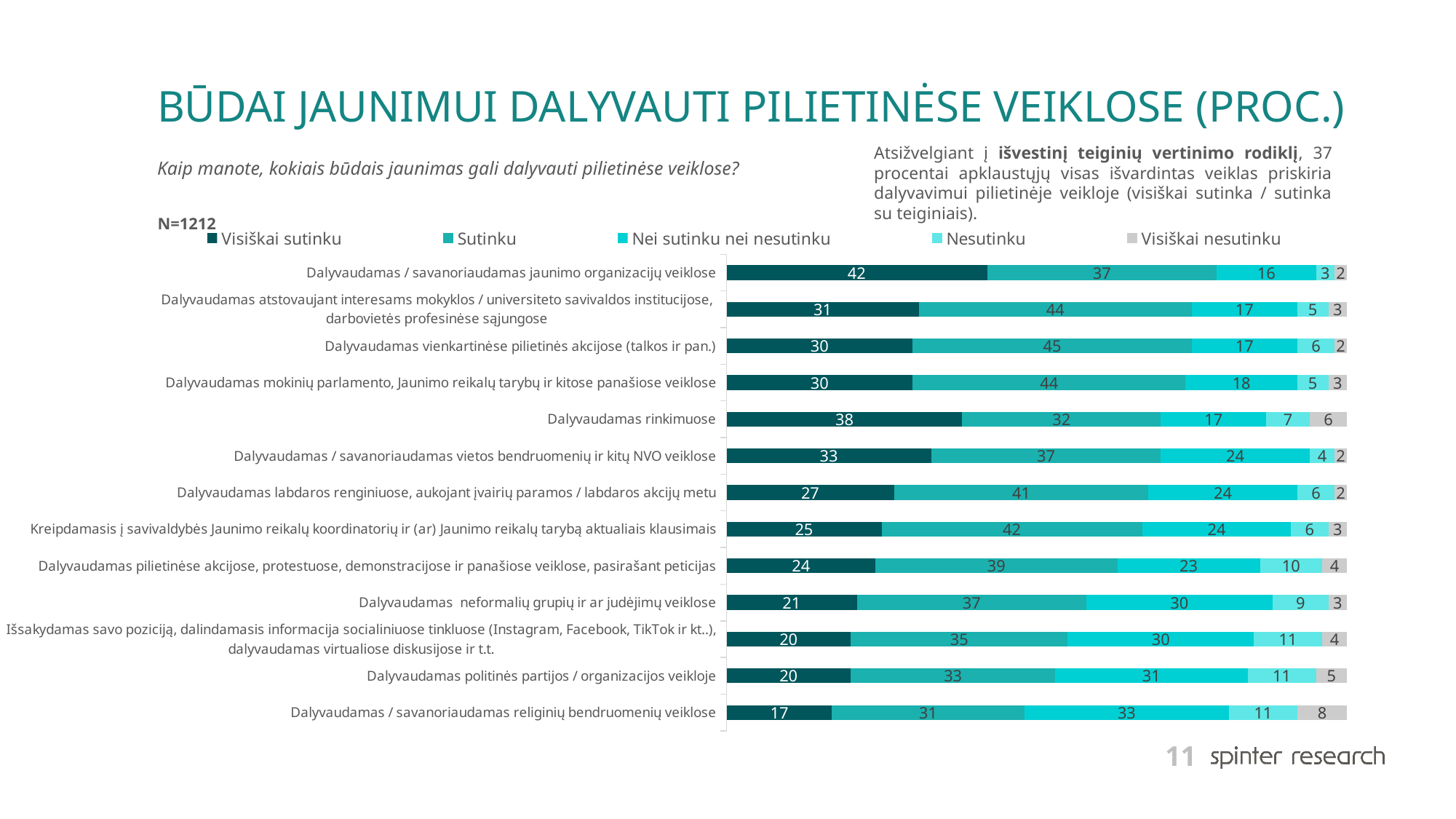
What kind of chart is shown on the slide? Stacked bar chart What is the 'Visiškai nesutinku' value for 'Dalyvaudamas rinkimuose'? 6 Which category has the lowest 'Visiškai sutinku' value? Dalyvaudamas / savanoriaudamas religinių bendruomenių veiklose Which category has the highest 'Visiškai sutinku' value? Dalyvaudamas / savanoriaudamas jaunimo organizacijų veiklose What is the combined 'Visiškai sutinku' and 'Sutinku' value for 'Dalyvaudamas mokinių parlamento, Jaunimo reikalų tarybų ir kitose panašiose veiklose'? 74 Which is larger: the 'Sutinku' value for 'Dalyvaudamas labdaros renginiuose, aukojant įvairių paramos / labdaros akcijų metu' or for 'Dalyvaudamas rinkimuose'? Dalyvaudamas labdaros renginiuose, aukojant įvairių paramos / labdaros akcijų metu What is the 'Sutinku' value for 'Dalyvaudamas vienkartinėse pilietinės akcijose (talkos ir pan.)'? 45 What is the 'Nei sutinku nei nesutinku' value for 'Dalyvaudamas / savanoriaudamas religinių bendruomenių veiklose'? 33 What is the difference between the 'Visiškai sutinku' values for 'Dalyvaudamas rinkimuose' and 'Dalyvaudamas politinės partijos / organizacijos veikloje'? 18 How many series does the legend list? 5 How many categories are shown in the chart? 13 What is the 'Visiškai sutinku' value for 'Dalyvaudamas / savanoriaudamas jaunimo organizacijų veiklose'? 42